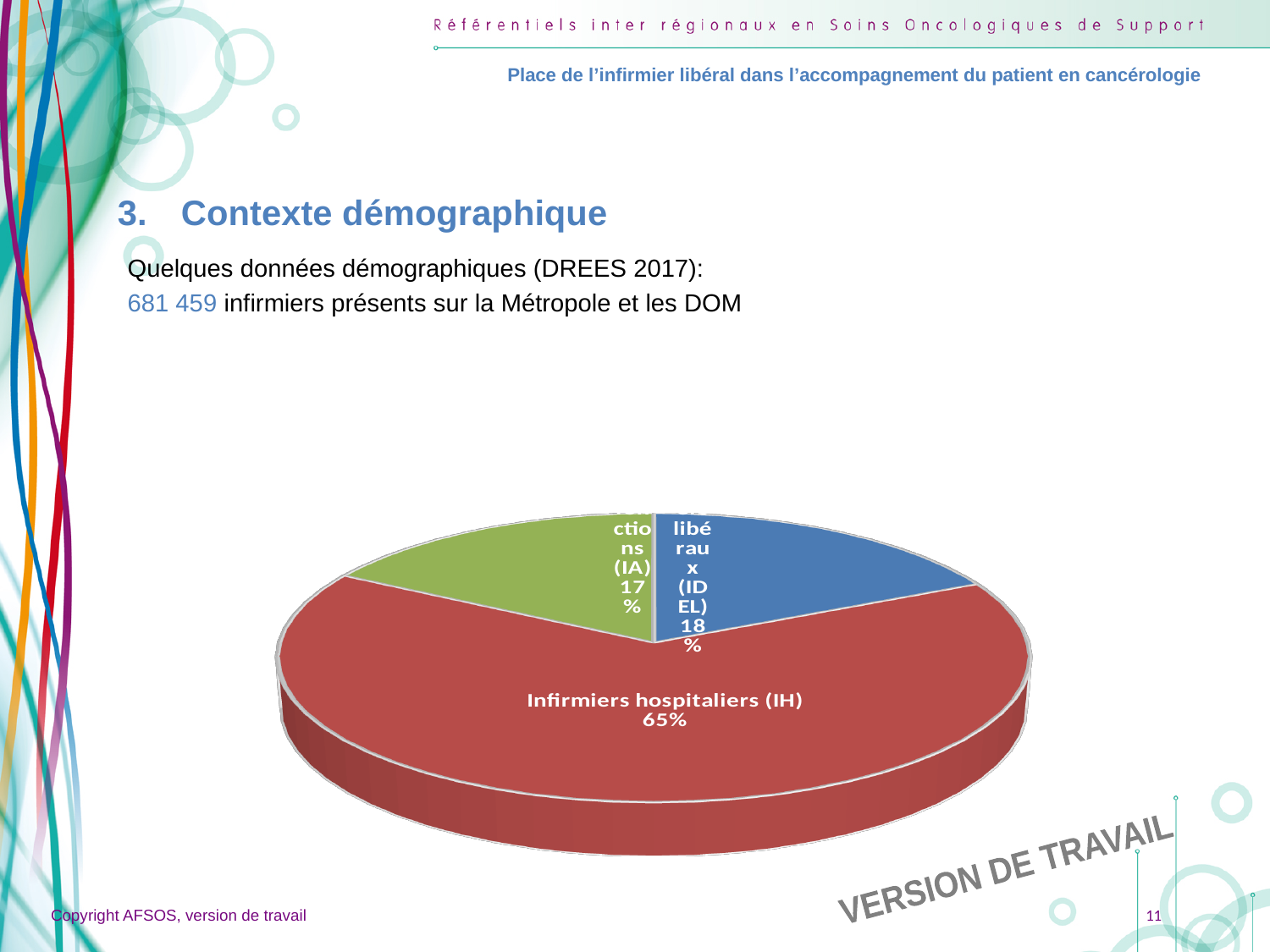
Which slice of the pie is the smallest? IA (17%) How many slices does the pie chart have? 3 What is the difference in percentage points between the IH slice and the IDEL slice? 47 What is the difference in percentage points between the IDEL slice and the IA slice? 1 What percentage is shown for the IDEL slice of the pie? 18% What colour is the Infirmiers hospitaliers (IH) slice? red Which slice of the pie is the largest? Infirmiers hospitaliers (IH) What colour is the IA slice of the pie? green What share of the pie is Infirmiers hospitaliers (IH)? 65% Which is larger, the IDEL slice or the IA slice? IDEL What kind of chart is shown on the slide? pie chart What percentage is shown for the IA slice of the pie? 17%